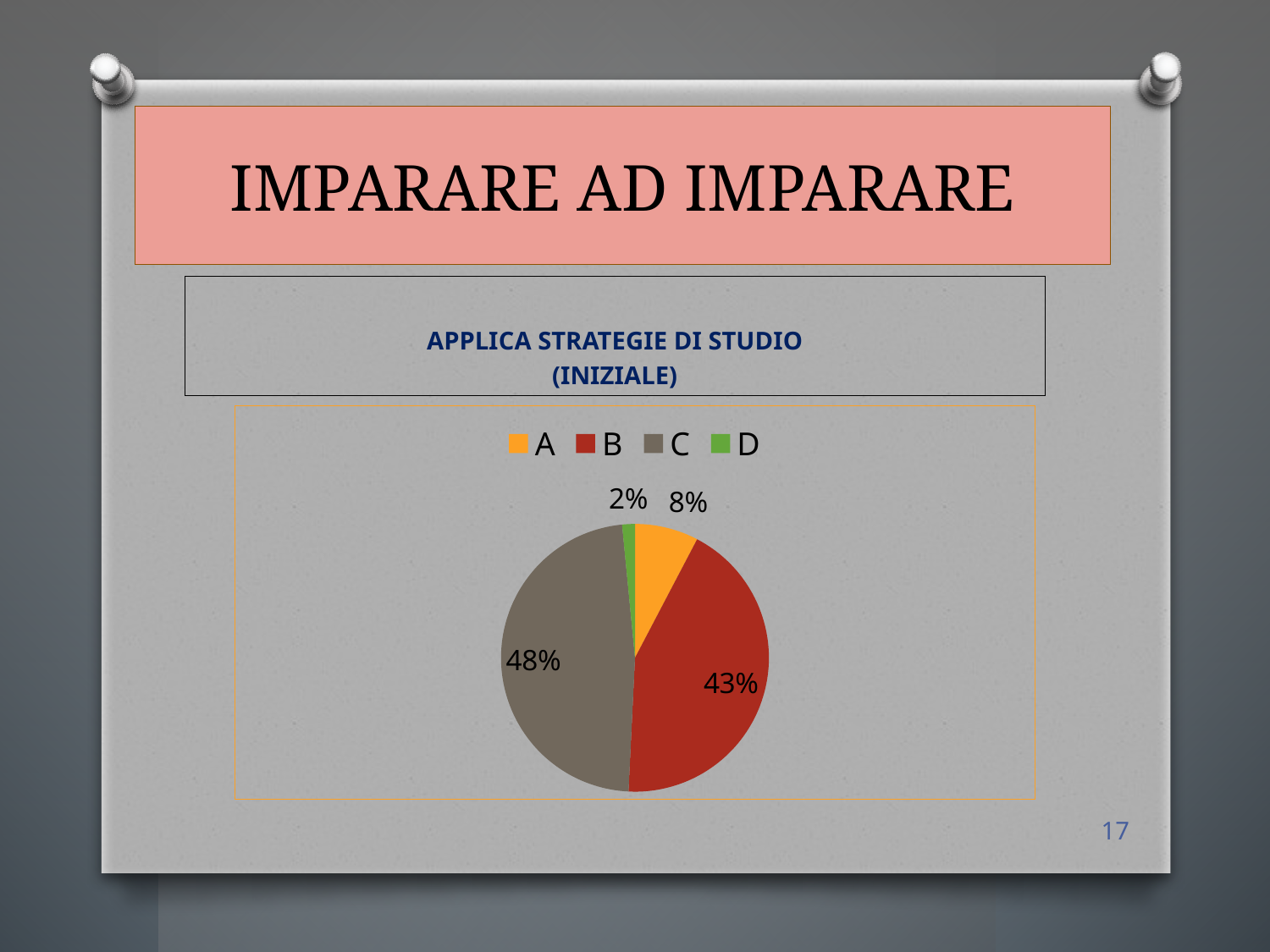
What is the value for category D in the pie chart? 2% What is the value for category B in the pie chart? 43% What is the title of the chart? APPLICA STRATEGIE DI STUDIO (INIZIALE) Which category has the largest slice of the pie chart? C What kind of chart is shown on the slide? pie chart How many categories does the pie chart show? 4 What is the value for category A in the pie chart? 8% Which category has the smallest slice of the pie chart? D Which is larger, the value for A or the value for D? A How many entries does the legend list? 4 What is the value for category C in the pie chart? 48% What is the difference between the values for C and B? 5%